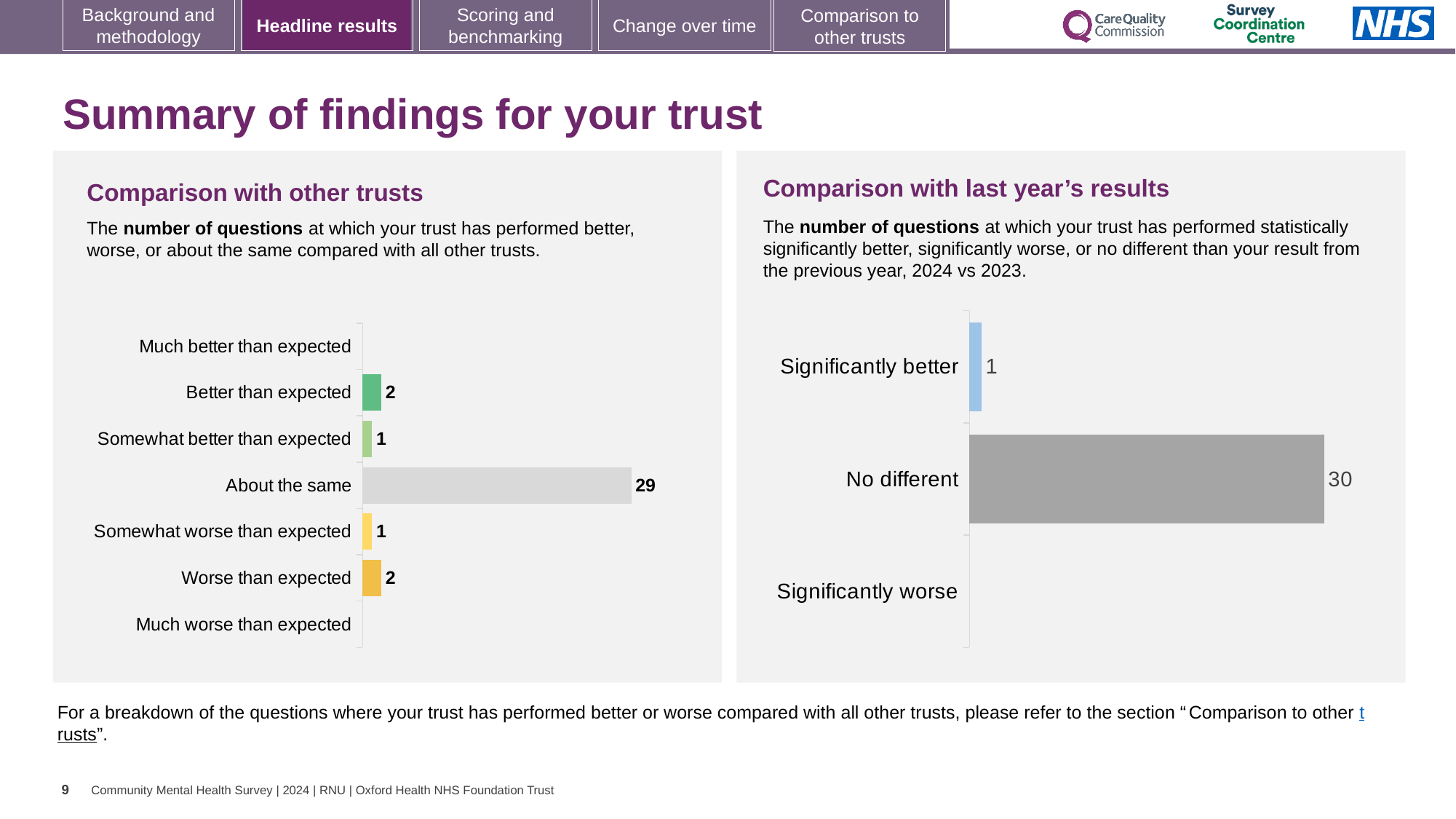
In the 'Comparison with other trusts' chart, what is the difference between 'About the same' and 'Better than expected'? 27 In the 'Comparison with other trusts' chart, what colour is the 'Better than expected' bar? Green In the 'Comparison with other trusts' chart, which is larger: 'Worse than expected' or 'Somewhat better than expected'? Worse than expected In the 'Comparison with other trusts' chart, what is the value for 'Better than expected'? 2 In the 'Comparison with other trusts' chart, which category has the highest value? About the same In the 'Comparison with other trusts' chart, how many categories are listed on the axis? 7 What type of chart is the 'Comparison with last year's results' chart? Bar chart In the 'Comparison with last year's results' chart, what is the value for 'Significantly better'? 1 In the 'Comparison with other trusts' chart, how many questions are 'About the same'? 29 In the 'Comparison with other trusts' chart, what is the value for 'Somewhat worse than expected'? 1 In the 'Comparison with last year's results' chart, which category has the lowest value among those with a bar shown? Significantly better In the 'Comparison with last year's results' chart, what is the value for 'No different'? 30